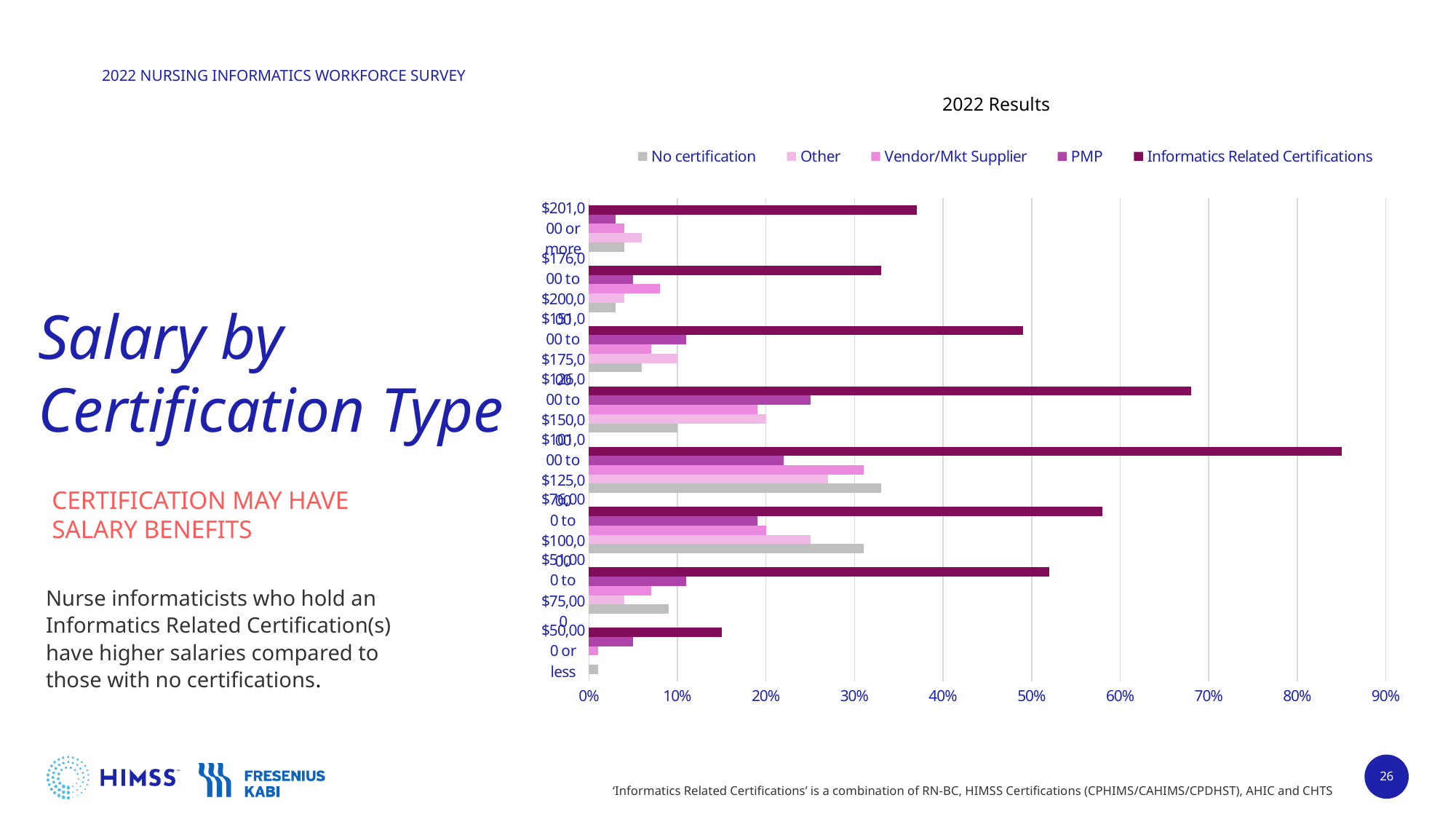
Which salary band has the highest value for Informatics Related Certifications? $101,000 to $125,000 For the $201,000 or more band, which is larger: Informatics Related Certifications or PMP? Informatics Related Certifications How many series does the legend of the chart list? 5 How many salary bands (categories) are plotted on the chart? 8 Is the Informatics Related Certifications value for $50,000 or less greater or less than 20%? less For the $50,000 or less band, which is larger: Informatics Related Certifications or No certification? Informatics Related Certifications What kind of chart is shown on the slide? bar chart Is the No certification value for $101,000 to $125,000 greater or less than 20%? greater Is the Informatics Related Certifications value for $126,000 to $150,000 greater or less than 60%? greater Which salary band has the lowest value for Informatics Related Certifications? $50,000 or less What is the title of the chart? 2022 Results